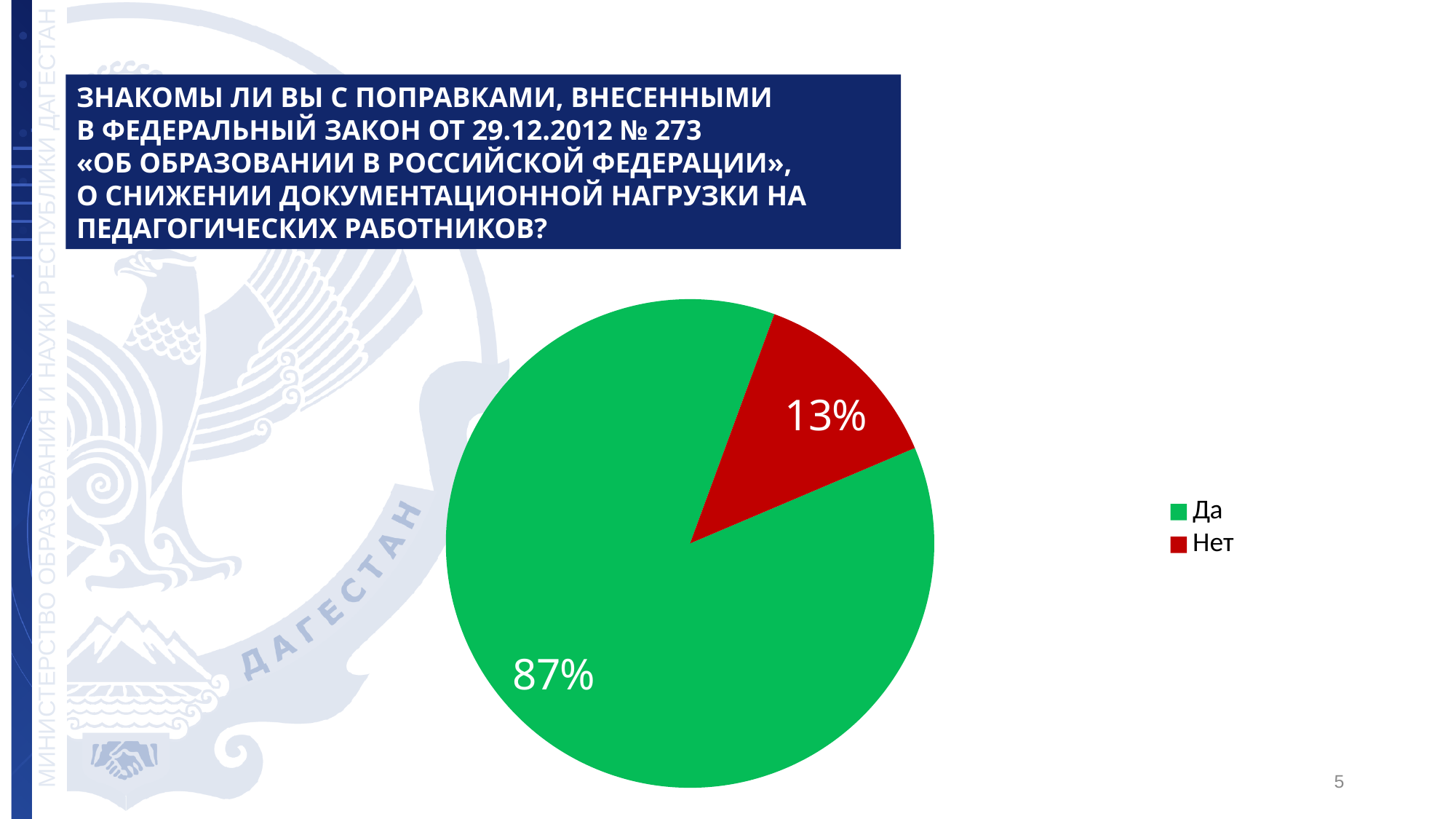
What kind of chart is shown on the slide? pie chart What share of the pie does the "Нет" slice represent? 13% What percentage of respondents answered "Да"? 87% What colour is the "Нет" slice? red Which slice is larger, "Да" or "Нет"? Да Which answer has the largest share of the pie? Да What colour is the "Да" slice? green What is the difference in percentage points between the "Да" and "Нет" slices? 74 Which answer has the smallest share of the pie? Нет How many slices does the pie chart have? 2 What percentage of respondents answered "Нет"? 13% How many entries does the legend list? 2